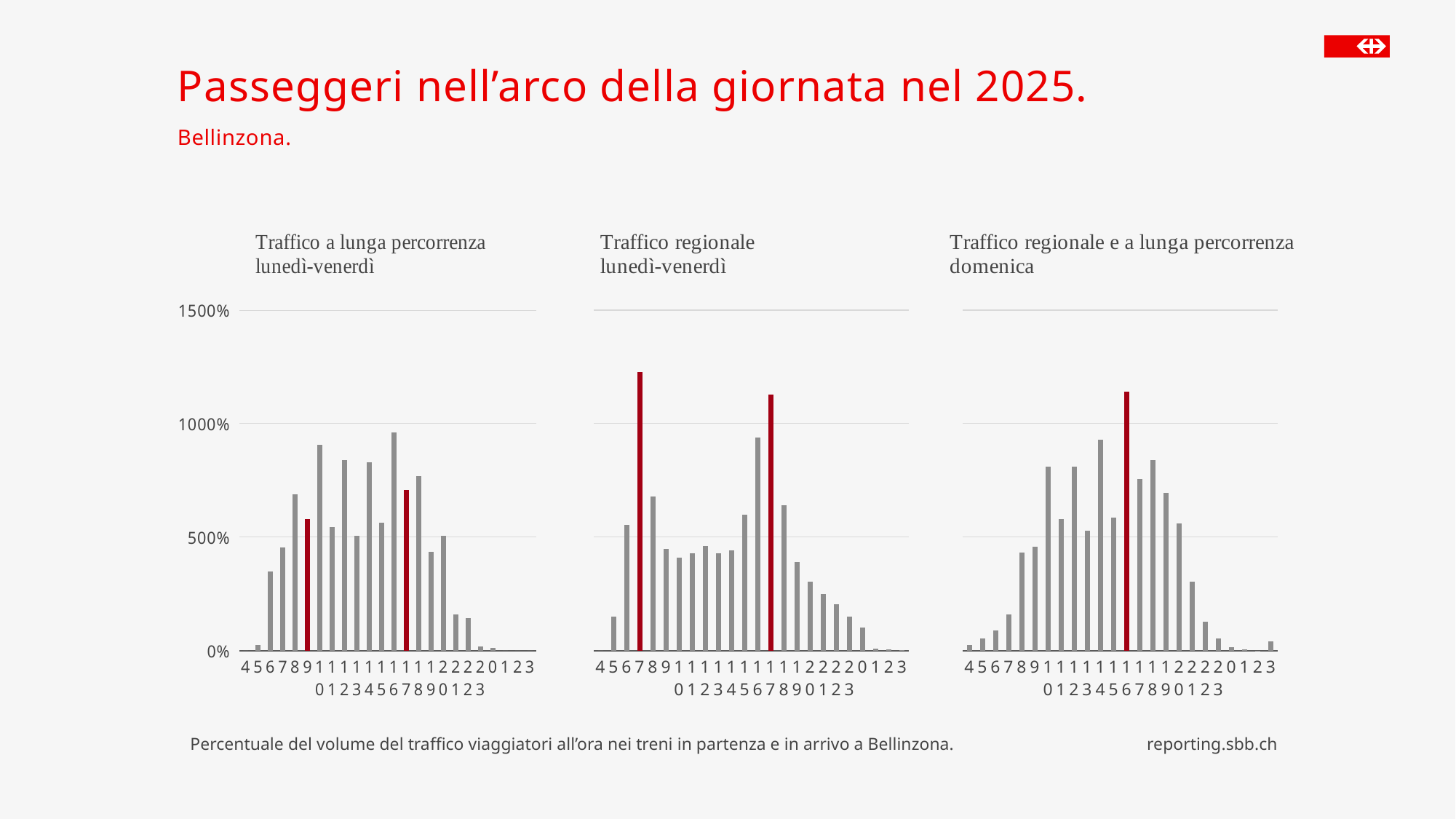
Which of the three charts contains the single tallest bar? Traffico regionale lunedì-venerdì What is the highest value shown on the y axis of the 'Traffico a lunga percorrenza lunedì-venerdì' chart? 1500% How many bars are highlighted in red in the 'Traffico regionale lunedì-venerdì' chart? 2 What kind of charts are shown on the slide? Bar charts In the 'Traffico regionale lunedì-venerdì' chart, is the tallest bar greater or less than 1000%? greater In the 'Traffico a lunga percorrenza lunedì-venerdì' chart, is the tallest bar greater or less than 1000%? less What is the title of the rightmost chart? Traffico regionale e a lunga percorrenza domenica How many hour categories are shown on the x axis of the 'Traffico a lunga percorrenza lunedì-venerdì' chart? 24 How many charts are shown on the slide? 3 In the 'Traffico regionale e a lunga percorrenza domenica' chart, is the tallest bar greater or less than 1000%? greater How many bars are highlighted in red in the 'Traffico regionale e a lunga percorrenza domenica' chart? 1 In the 'Traffico regionale lunedì-venerdì' chart, do the bars after the second red bar rise or fall toward hour 23? fall